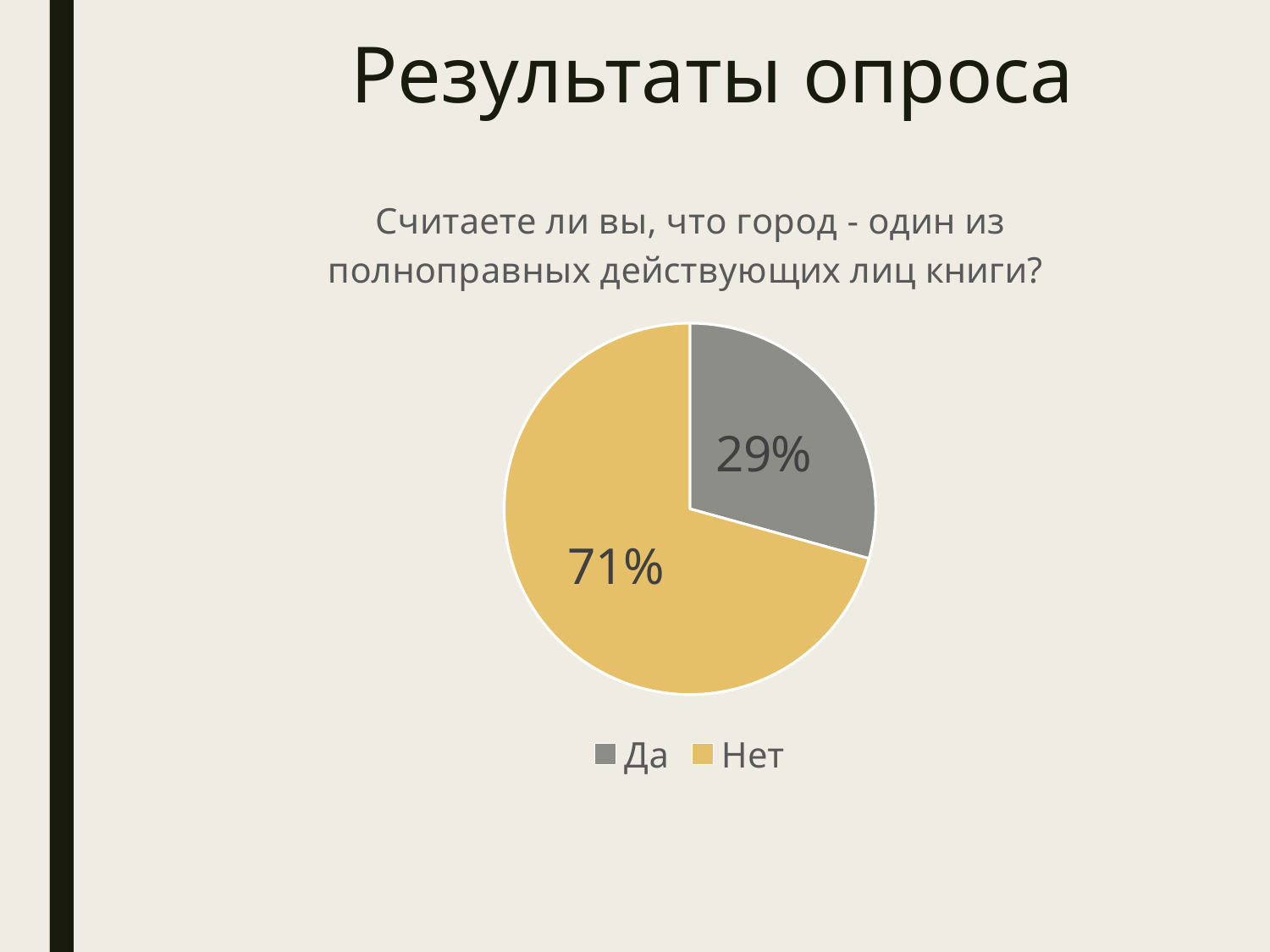
What percentage of respondents answered "Да"? 29% What type of chart is shown on the slide? pie chart What percentage of respondents answered "Нет"? 71% How many entries does the legend list? 2 Which answer has the largest share of the pie? Нет How many slices does the pie chart have? 2 What colour is the "Нет" slice? yellow What is the title of the chart? Считаете ли вы, что город - один из полноправных действующих лиц книги? What is the difference in percentage points between the "Нет" and "Да" slices? 42 What share of the pie does the "Да" slice represent? 29% Which is larger, the share for "Да" or the share for "Нет"? Нет Which answer has the smallest share of the pie? Да